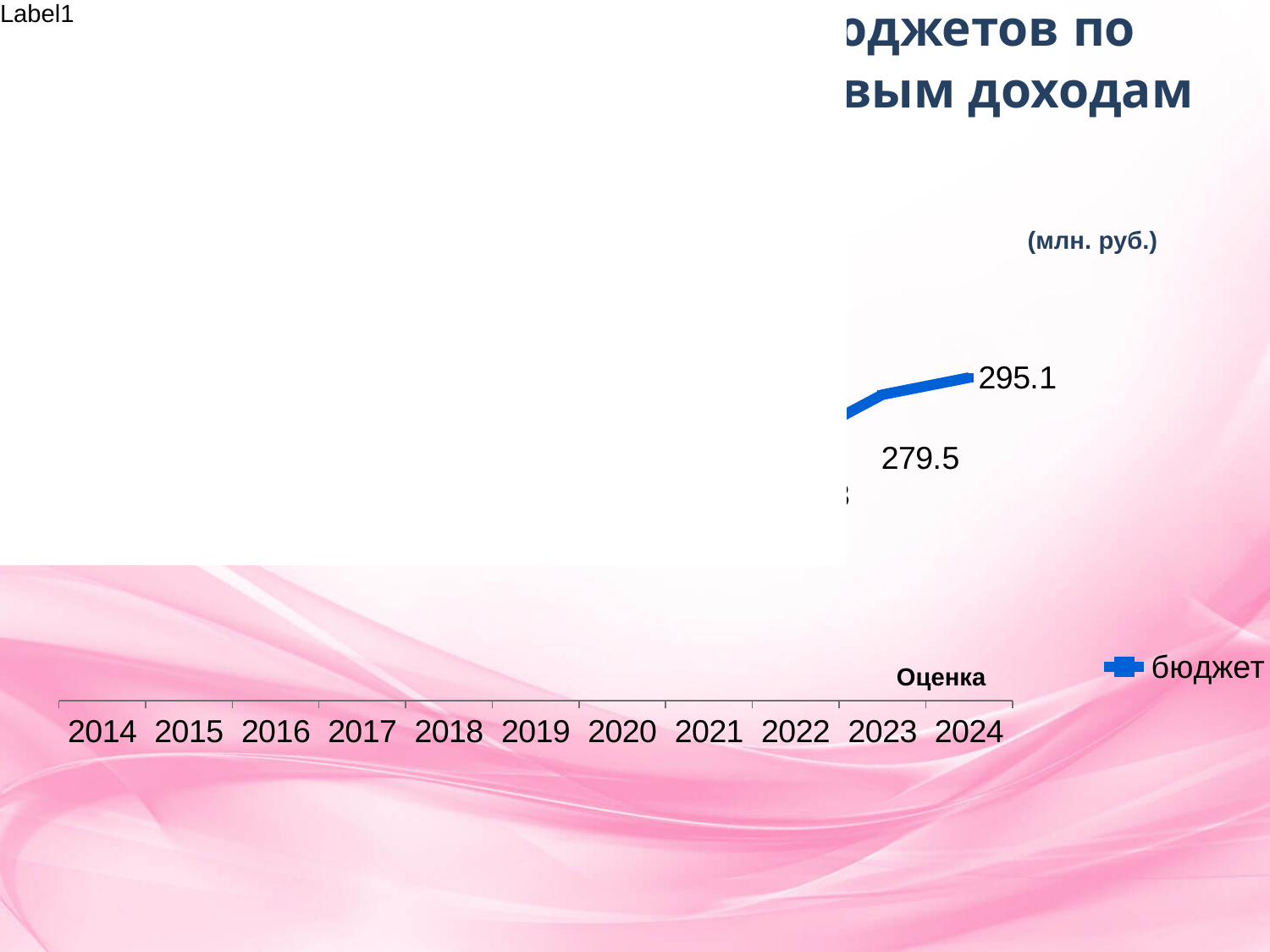
What is the value for 2024 in the chart? 295.1 What kind of chart is shown on the slide? line chart What is the value for 2023 in the chart? 279.5 Which is larger, the value for 2023 or the value for 2024? 2024 What is the name of the series in the chart legend? бюджет What is the last year shown on the x axis? 2024 How many years are shown on the x axis of the chart? 11 Does the value rise or fall from 2023 to 2024? rise What unit is indicated for the chart values? млн. руб. How many series does the chart legend list? 1 What is the difference between the values for 2024 and 2023? 15.6 What is the first year shown on the x axis? 2014